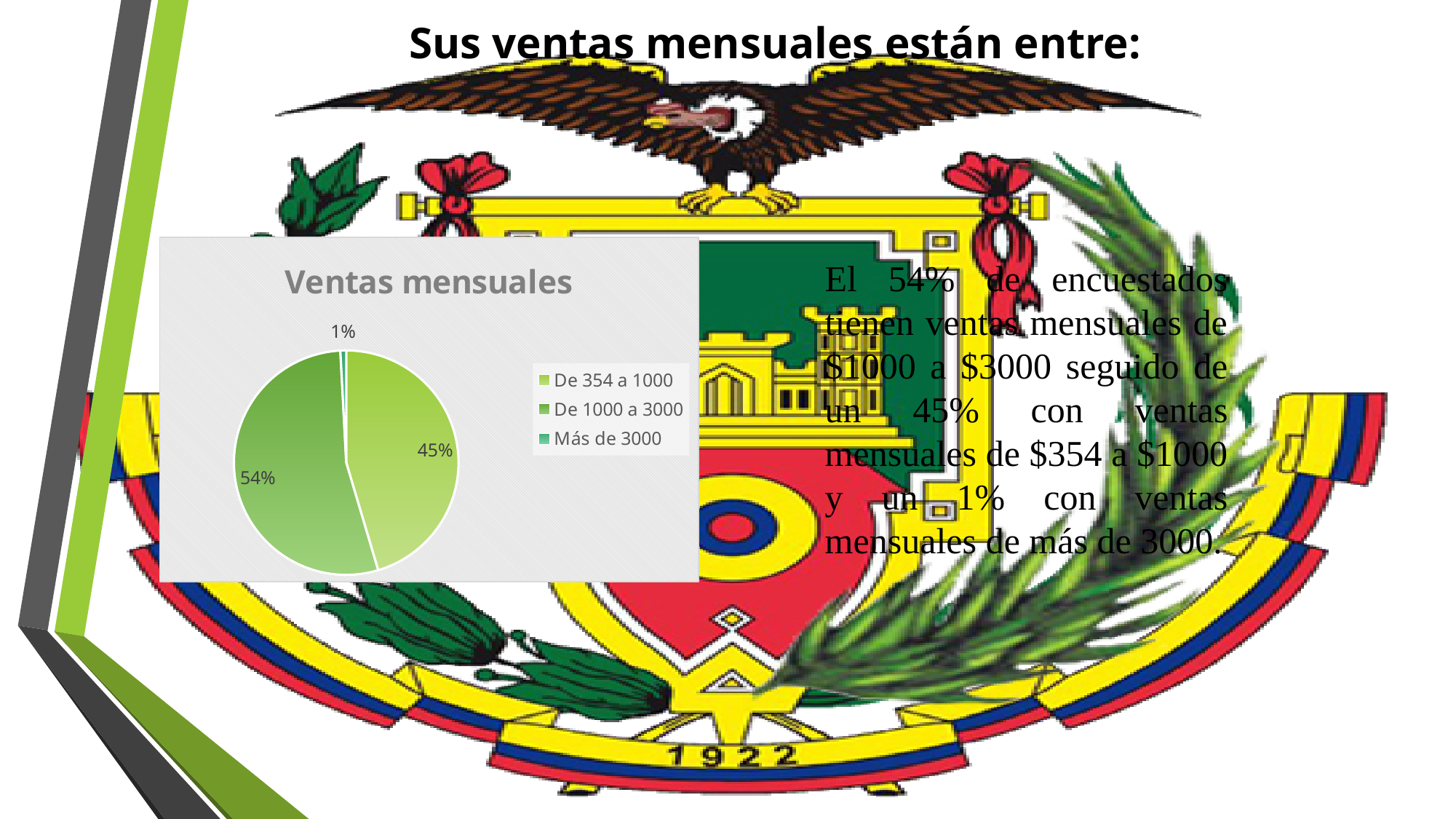
Which category has the smallest share of the pie? Más de 3000 What is the combined share of 'De 354 a 1000' and 'Más de 3000'? 46% What share of the pie is 'De 1000 a 3000'? 54% Which category has the largest share of the pie? De 1000 a 3000 How many entries does the legend list? 3 What is the difference in percentage points between 'De 1000 a 3000' and 'De 354 a 1000'? 9 What share of the pie is 'De 354 a 1000'? 45% What share of the pie is 'Más de 3000'? 1% What type of chart is shown on the slide? Pie chart What is the title of the chart? Ventas mensuales Which is larger, the share for 'De 354 a 1000' or the share for 'Más de 3000'? De 354 a 1000 How many categories does the pie chart have? 3